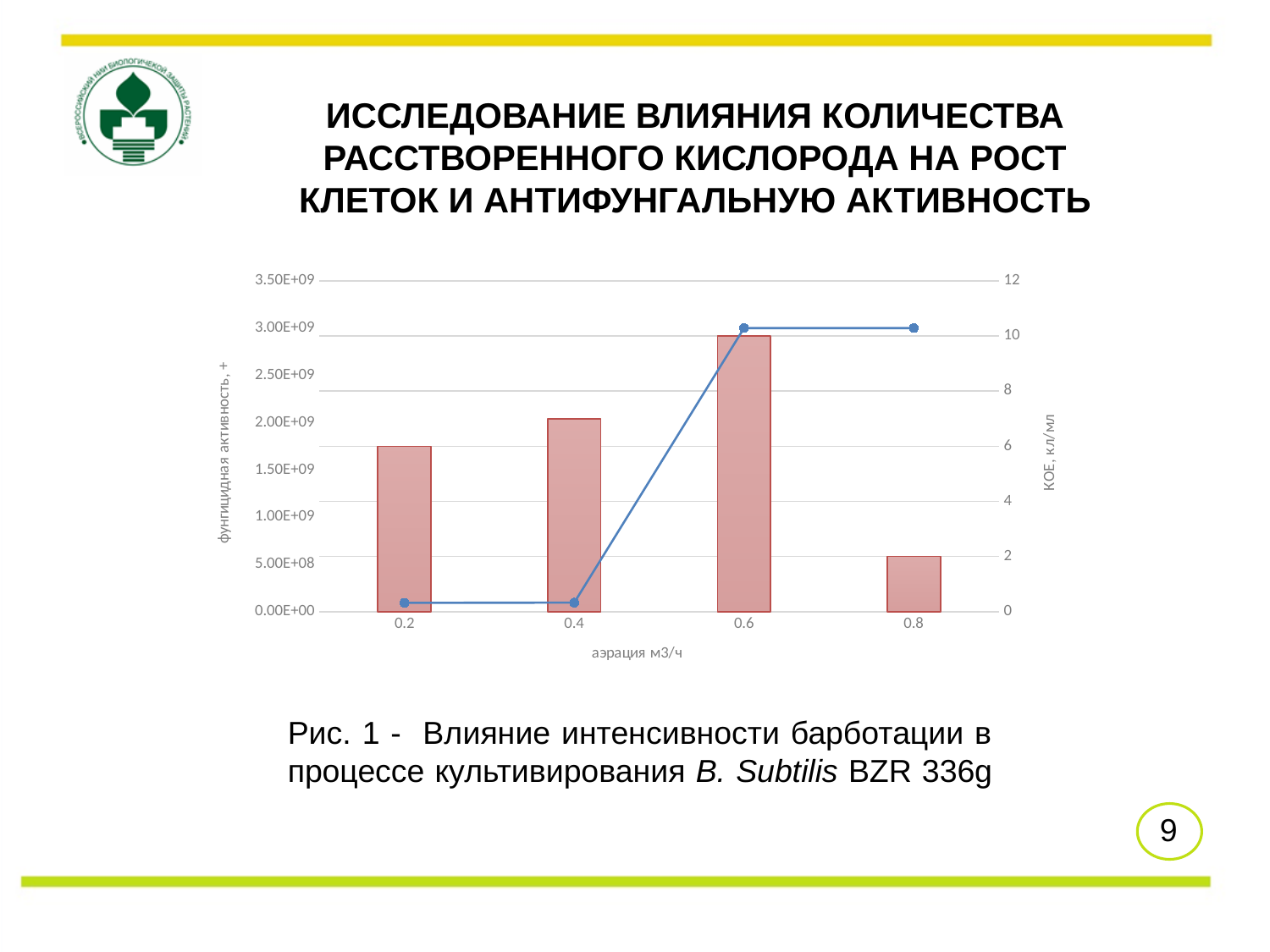
Is the bar value for aeration 0.6 greater or less than 2.50E+09 on the left axis? greater At which aeration value is the bar the tallest? 0.6 What is the title of the right-hand vertical axis? КОЕ, кл/мл What kind of chart is shown on the slide? A bar chart combined with a line Which bar is taller, the one at aeration 0.4 or the one at aeration 0.6? 0.6 At which aeration value is the bar the shortest? 0.8 Is the bar value for aeration 0.2 greater or less than 1.50E+09 on the left axis? greater What is the title of the x axis? аэрация м3/ч Is the bar value for aeration 0.8 greater or less than 1.00E+09 on the left axis? less Which bar is taller, the one at aeration 0.2 or the one at aeration 0.8? 0.2 How many aeration categories are shown on the x axis? 4 Does the blue line rise or fall as aeration increases from 0.4 to 0.6? rises